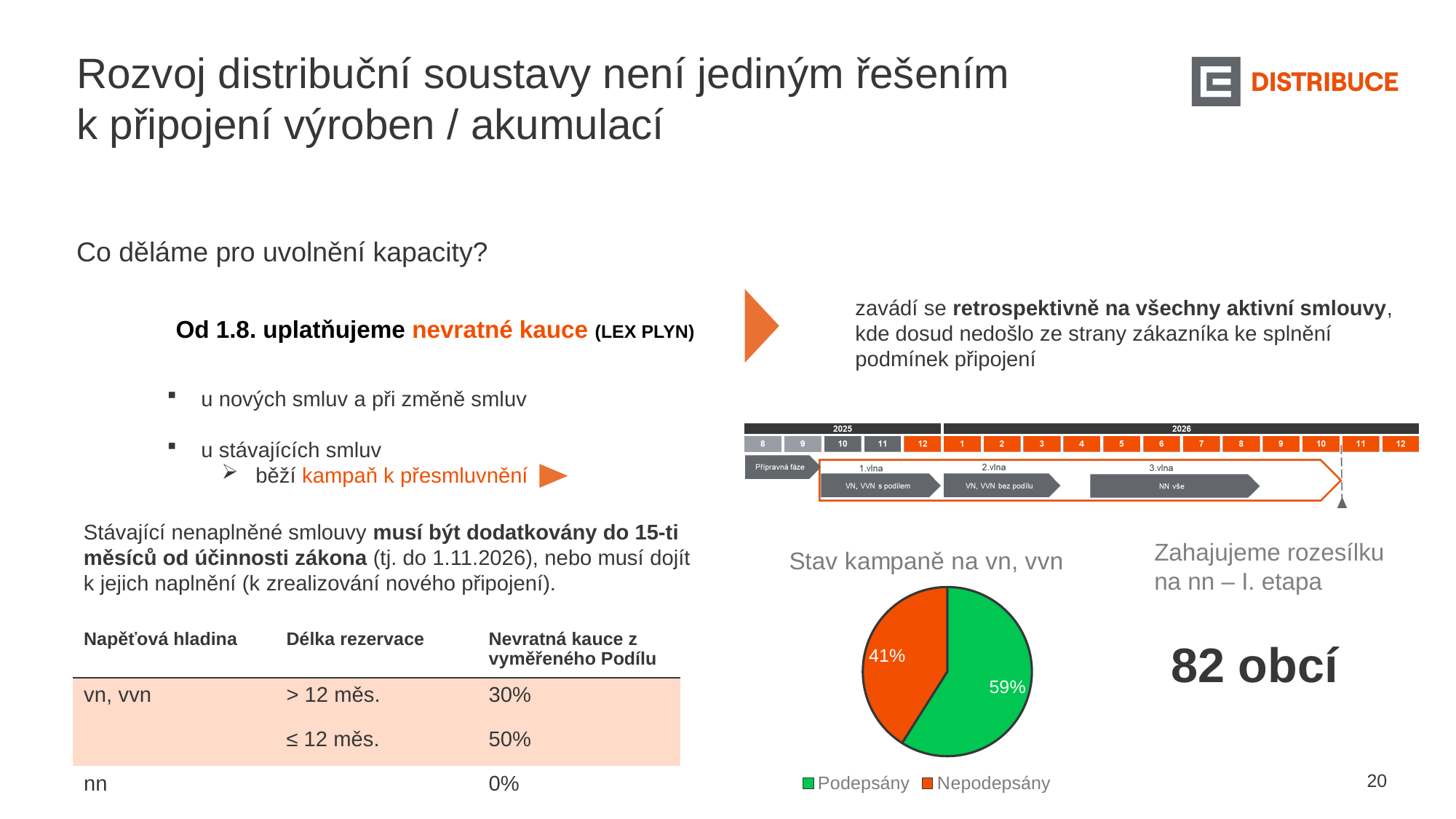
In the pie chart "Stav kampaně na vn, vvn", what is the difference in percentage points between Podepsány and Nepodepsány? 18 percentage points In the pie chart "Stav kampaně na vn, vvn", what share is labelled for Nepodepsány? 41% In the pie chart "Stav kampaně na vn, vvn", what colour is the Nepodepsány slice? orange How many entries does the legend of the pie chart "Stav kampaně na vn, vvn" list? 2 What kind of chart is shown under the title "Stav kampaně na vn, vvn"? pie chart How many slices does the pie chart "Stav kampaně na vn, vvn" have? 2 In the pie chart "Stav kampaně na vn, vvn", which slice is the largest? Podepsány In the pie chart "Stav kampaně na vn, vvn", what share is labelled for Podepsány? 59% In the pie chart "Stav kampaně na vn, vvn", which is larger: Podepsány or Nepodepsány? Podepsány In the pie chart "Stav kampaně na vn, vvn", which slice is the smallest? Nepodepsány In the pie chart "Stav kampaně na vn, vvn", what colour is the Podepsány slice? green What is the title of the pie chart on the slide? Stav kampaně na vn, vvn